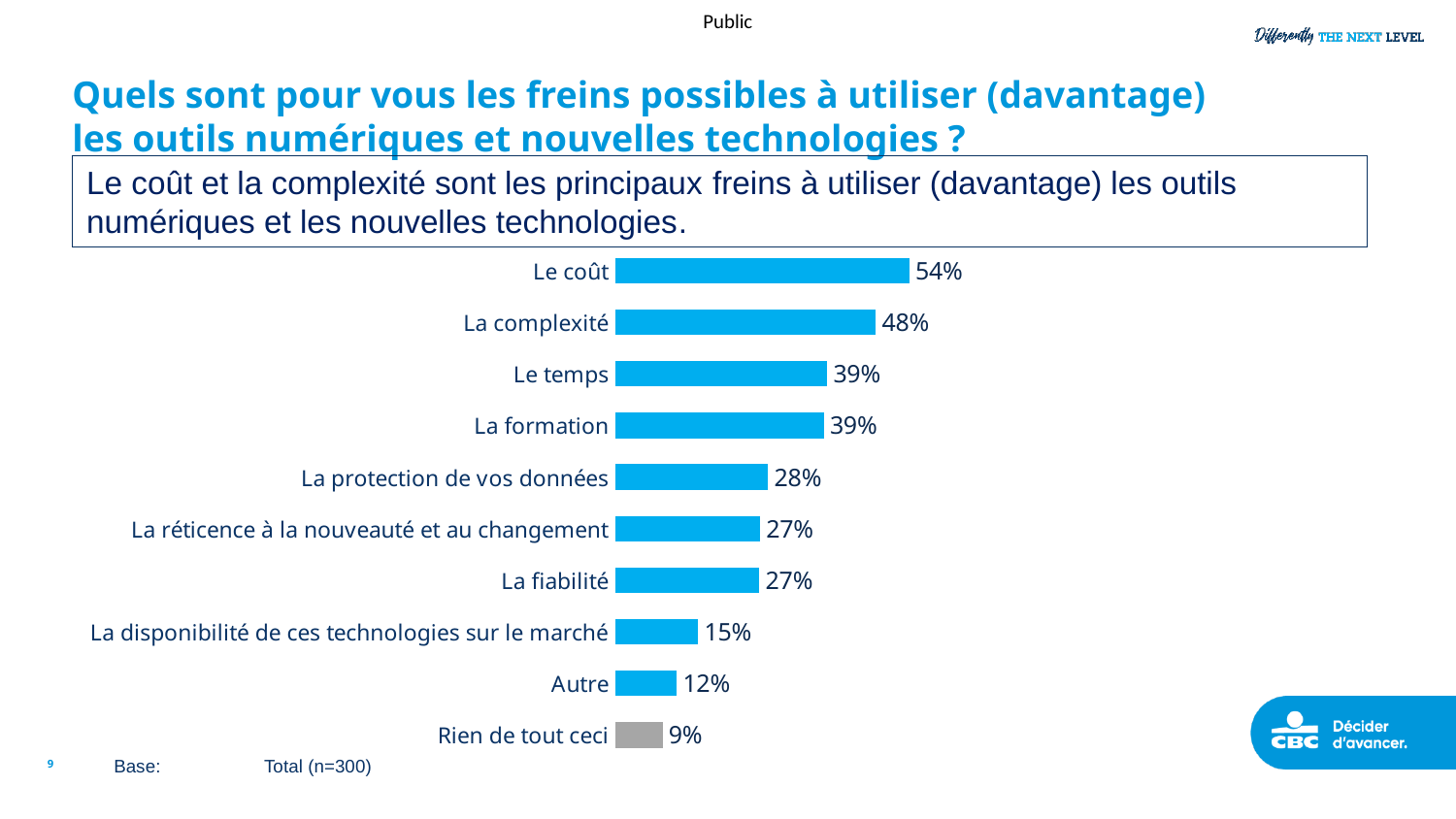
Which category has the lowest value? Rien de tout ceci What is the difference between the values for "Le coût" and "La complexité"? 6% Which bar is shown in a different colour (grey) from the others? Rien de tout ceci Which category has the highest value? Le coût Which is larger, the value for "Autre" or the value for "Rien de tout ceci"? Autre Which is larger, the value for "La complexité" or the value for "Le temps"? La complexité What is the value for "Le coût"? 54% What kind of chart is shown on the slide? Bar chart What is the value for "La protection de vos données"? 28% What is the value for "La disponibilité de ces technologies sur le marché"? 15% How many categories are shown in the chart? 10 What is the difference between the values for "La formation" and "Autre"? 27%